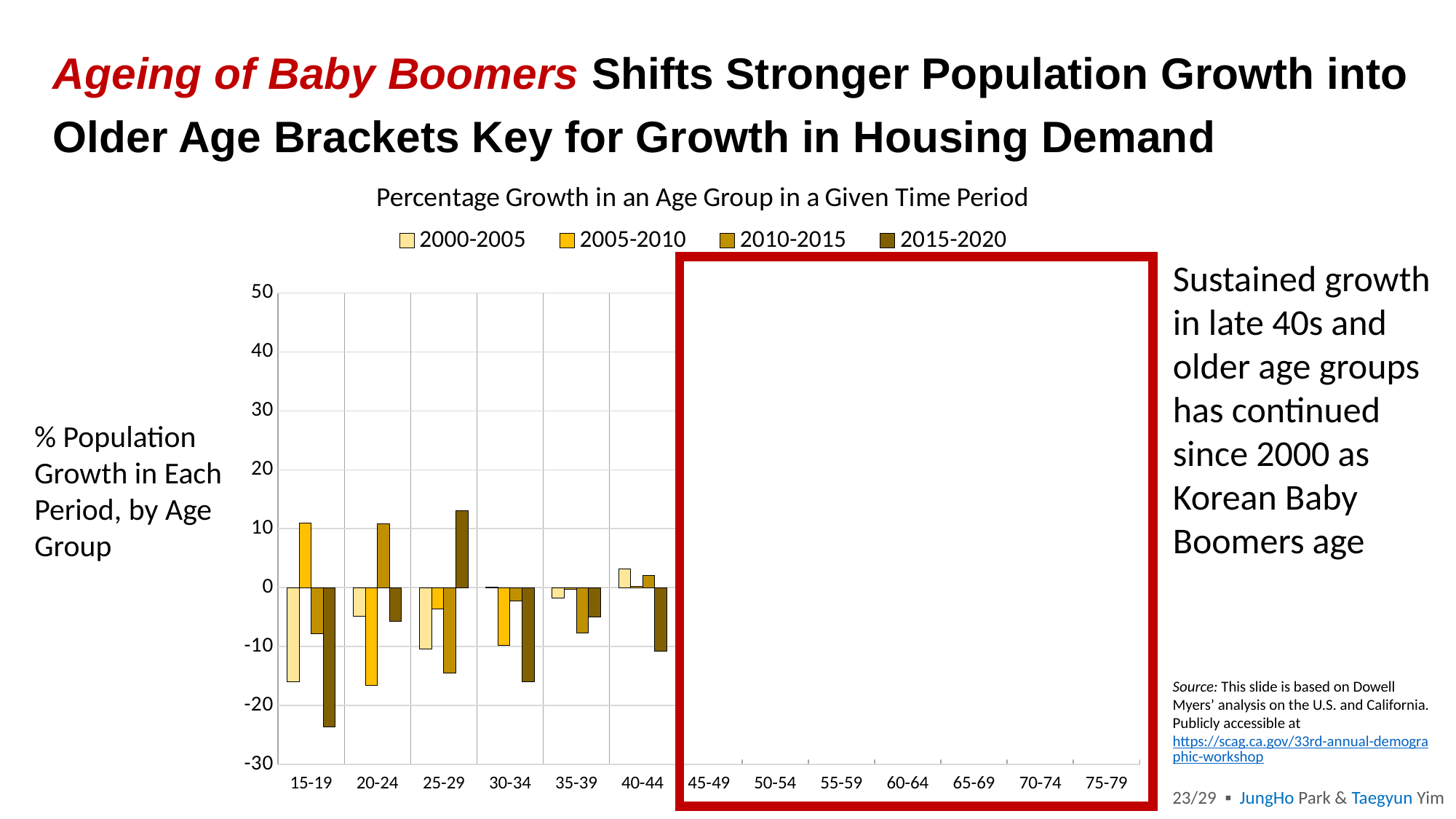
Is the 2005-2010 value for the 15-19 age group greater or less than 10? greater For the 20-24 age group, which series has the larger value: 2010-2015 or 2015-2020? 2010-2015 Is the 2005-2010 value for the 20-24 age group greater or less than -10? less Among the age groups with visible bars, which has the lowest 2015-2020 value? 15-19 Is the 2015-2020 value for the 15-19 age group greater or less than -20? less What kind of chart is shown on the slide? bar chart What is the title of the chart? Percentage Growth in an Age Group in a Given Time Period How many series does the legend list? 4 How many age-group categories are labelled on the x axis? 13 Which is lower: the 2015-2020 value for 15-19 or the 2005-2010 value for 20-24? 2015-2020 value for 15-19